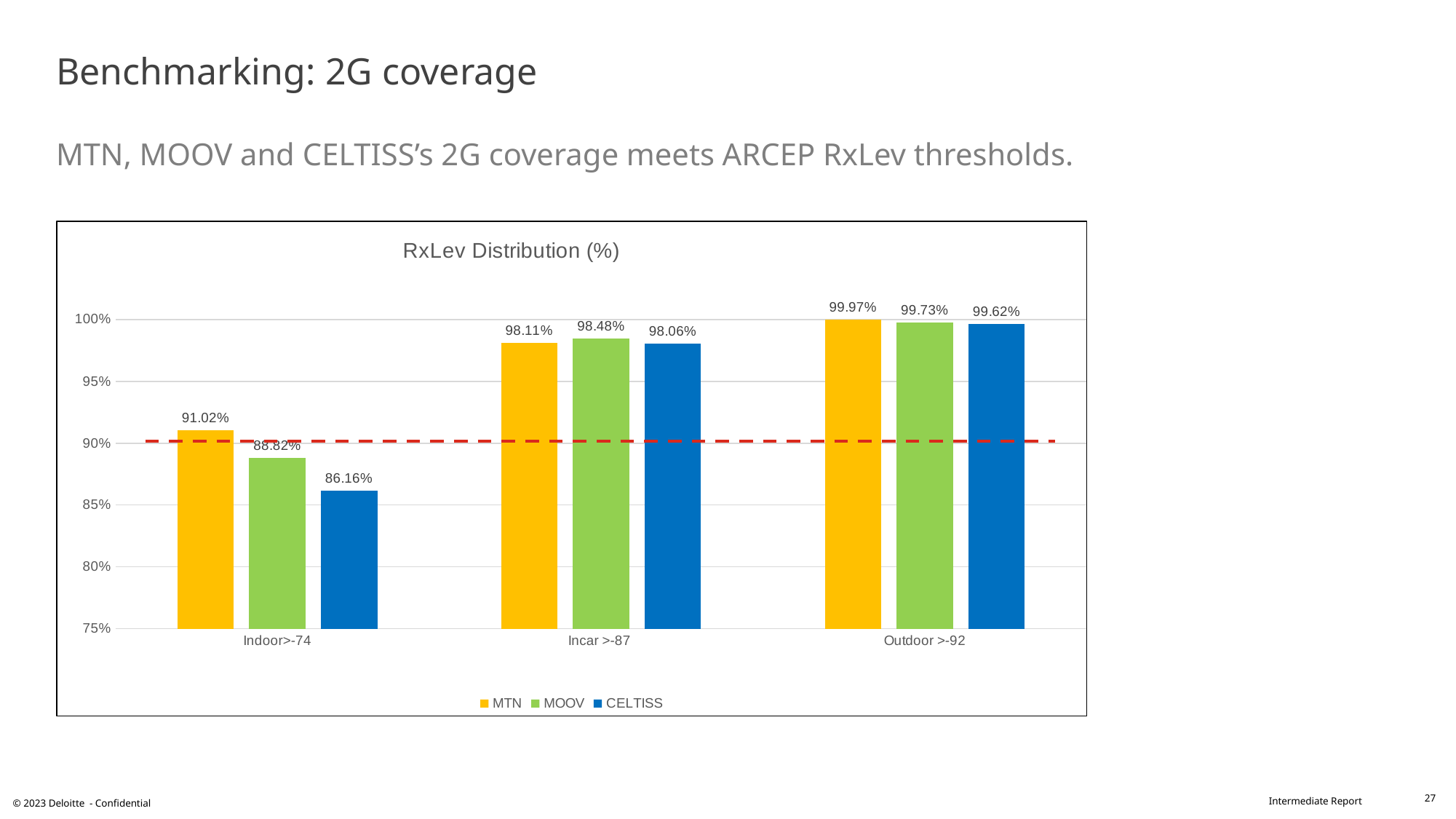
How many categories are shown on the x axis? 3 What is the CELTISS value for Incar >-87? 98.06% Which operator has the lowest value for Indoor>-74? CELTISS What is the MTN value for Indoor>-74? 91.02% What kind of chart is shown? bar chart What is the difference between the MTN and CELTISS values for Indoor>-74? 4.86% How many series does the legend list? 3 What is the MOOV value for Outdoor >-92? 99.73% Is the MOOV value for Indoor>-74 greater or less than 90%? less What is the title of the chart? RxLev Distribution (%) Which operator has the highest value for Outdoor >-92? MTN Which is larger for Incar >-87: the MTN value or the MOOV value? MOOV